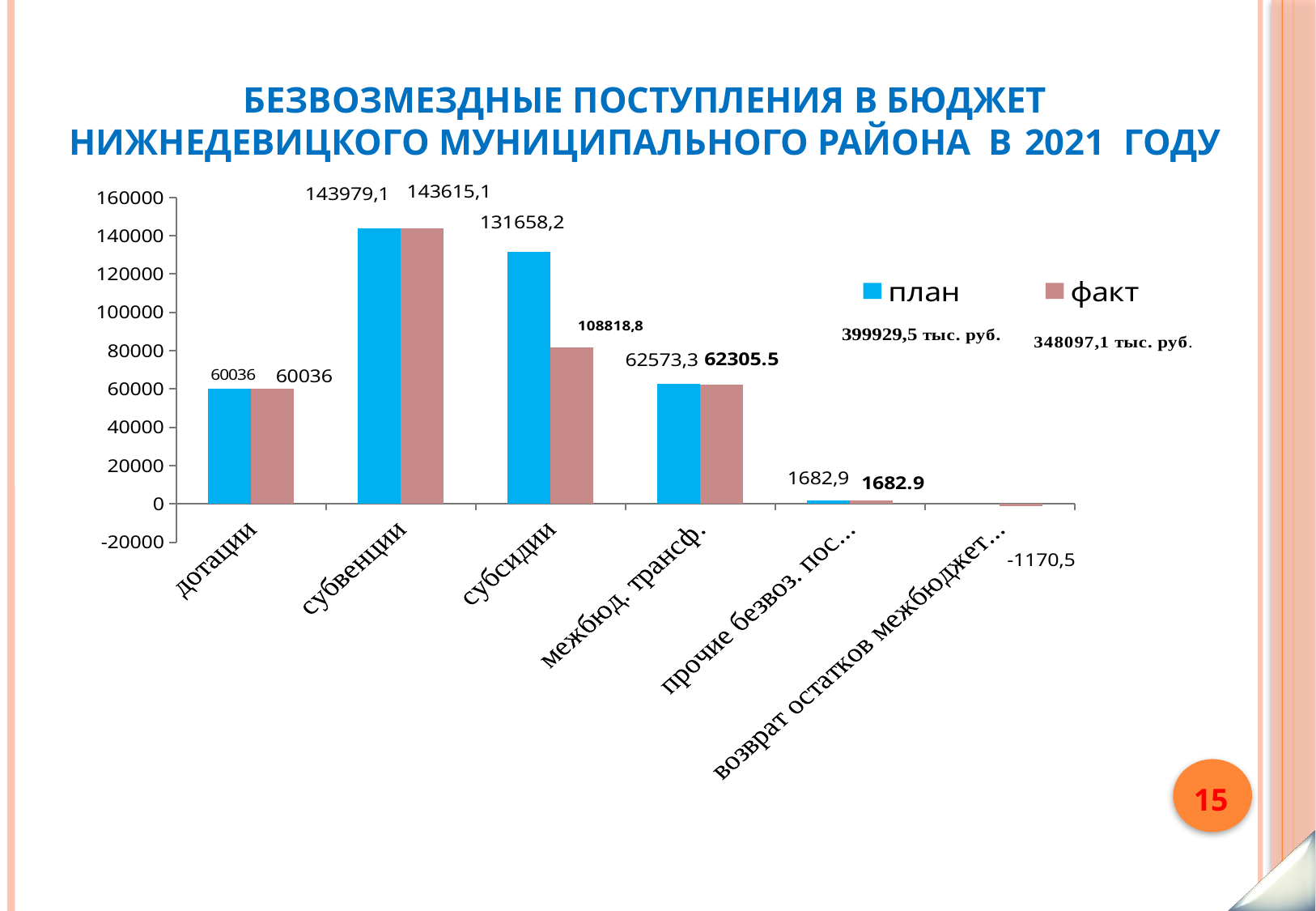
What is the план value for дотации? 60036 What total is shown next to the факт legend entry? 348097,1 тыс. руб. What is the факт value for субсидии? 108818,8 What is the difference between the план and факт values for субсидии? 22839,4 What is the факт value for межбюд. трансф.? 62305.5 How many series does the legend list? 2 Which category has the highest план value? субвенции How many categories are shown on the x axis of the chart? 6 What is the план value for субвенции? 143979,1 What type of chart is shown on the slide? bar chart Which category has the lowest факт value? возврат остатков межбюджет... For субсидии, which is larger: the план value or the факт value? план